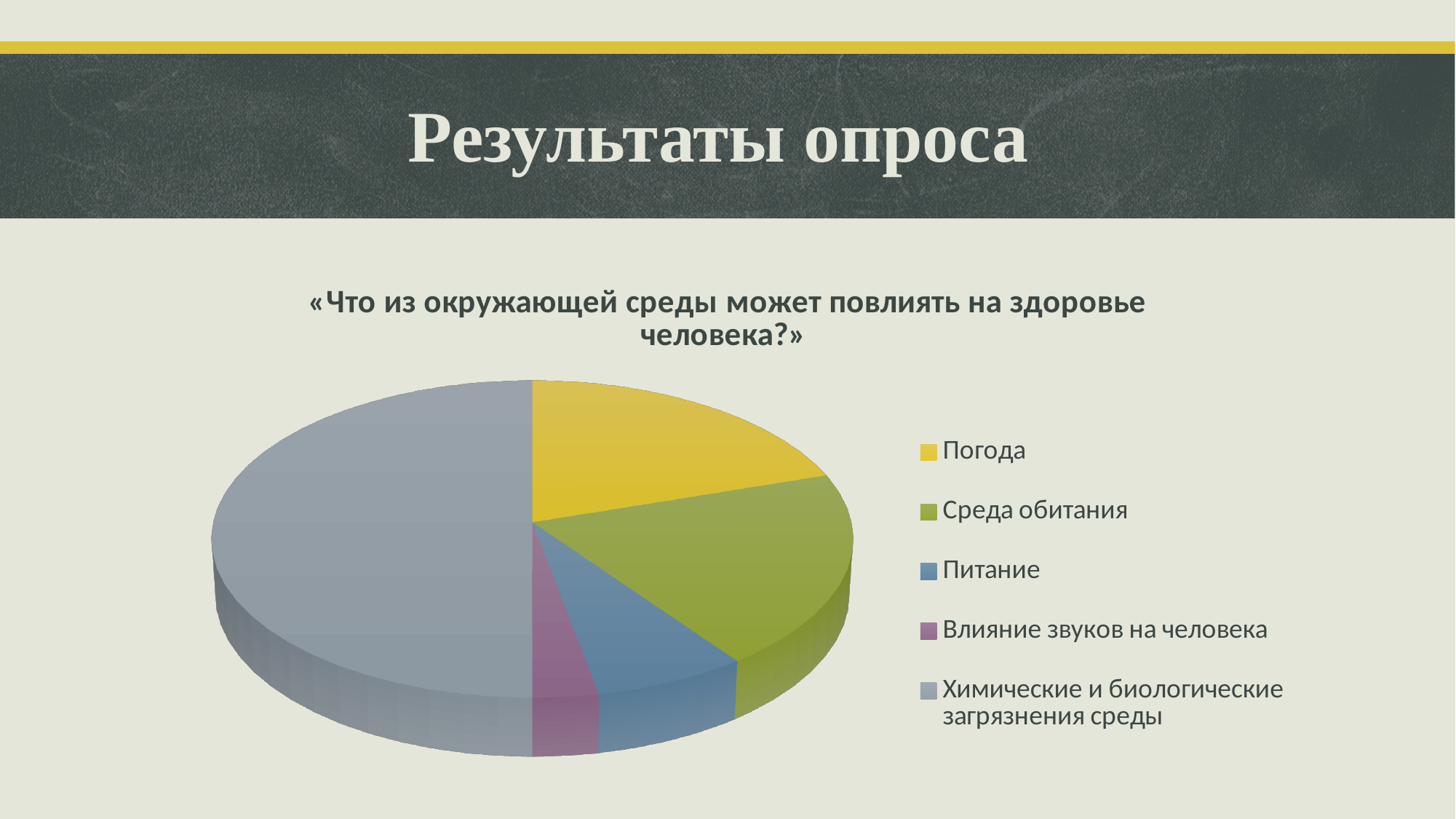
What is the title of the pie chart? «Что из окружающей среды может повлиять на здоровье человека?» Which slice is larger: Среда обитания or Питание? Среда обитания Which slice is larger: Погода or Питание? Погода Which slice is larger: Среда обитания or Влияние звуков на человека? Среда обитания Which category is shown in yellow in the pie chart? Погода Which category has the largest slice of the pie chart? Химические и биологические загрязнения среды Which category has the smallest slice of the pie chart? Влияние звуков на человека What kind of chart is shown on the slide? Pie chart How many categories does the pie chart show? 5